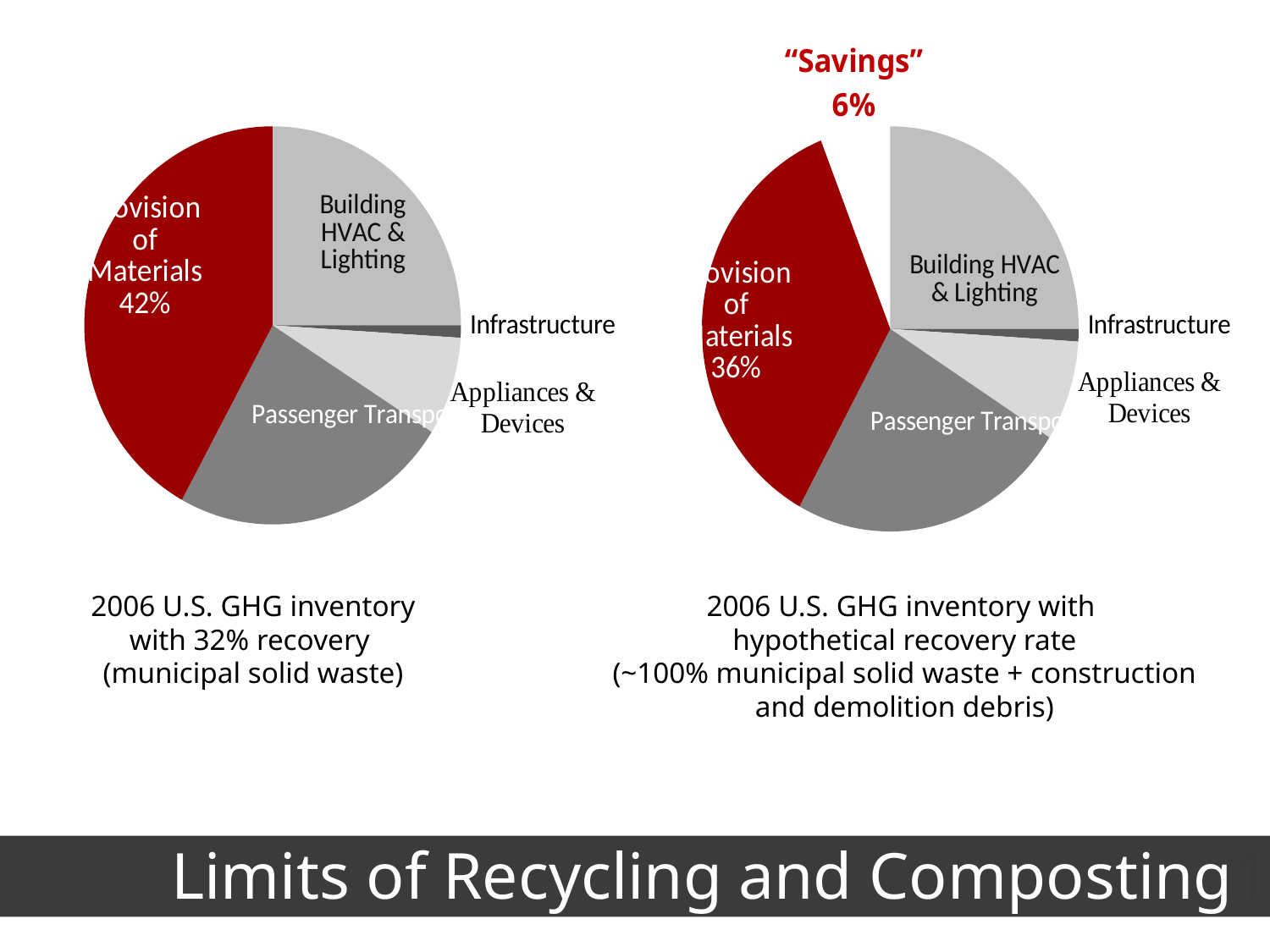
What kind of chart is used on this slide? Pie chart How many slices does the left pie chart (32% recovery) have? 5 By how many percentage points does the Provision of Materials share in the left pie chart exceed the Provision of Materials share in the right pie chart? 6 percentage points How many slices does the right pie chart (hypothetical recovery rate) have? 6 What colour is the Provision of Materials slice in both pie charts? Dark red In the right pie chart (hypothetical recovery rate), what share is labelled for Provision of Materials? 36% In the left pie chart (32% recovery), which slice is larger: Passenger Transport or Appliances & Devices? Passenger Transport In the left pie chart (32% recovery), which slice is the largest? Provision of Materials In the right pie chart (hypothetical recovery rate), what share is labelled for "Savings"? 6% In the right pie chart (hypothetical recovery rate), which slice is the smallest? Infrastructure In the left pie chart (32% recovery), which slice is the smallest? Infrastructure In the left pie chart (2006 U.S. GHG inventory with 32% recovery), what share is labelled for Provision of Materials? 42%